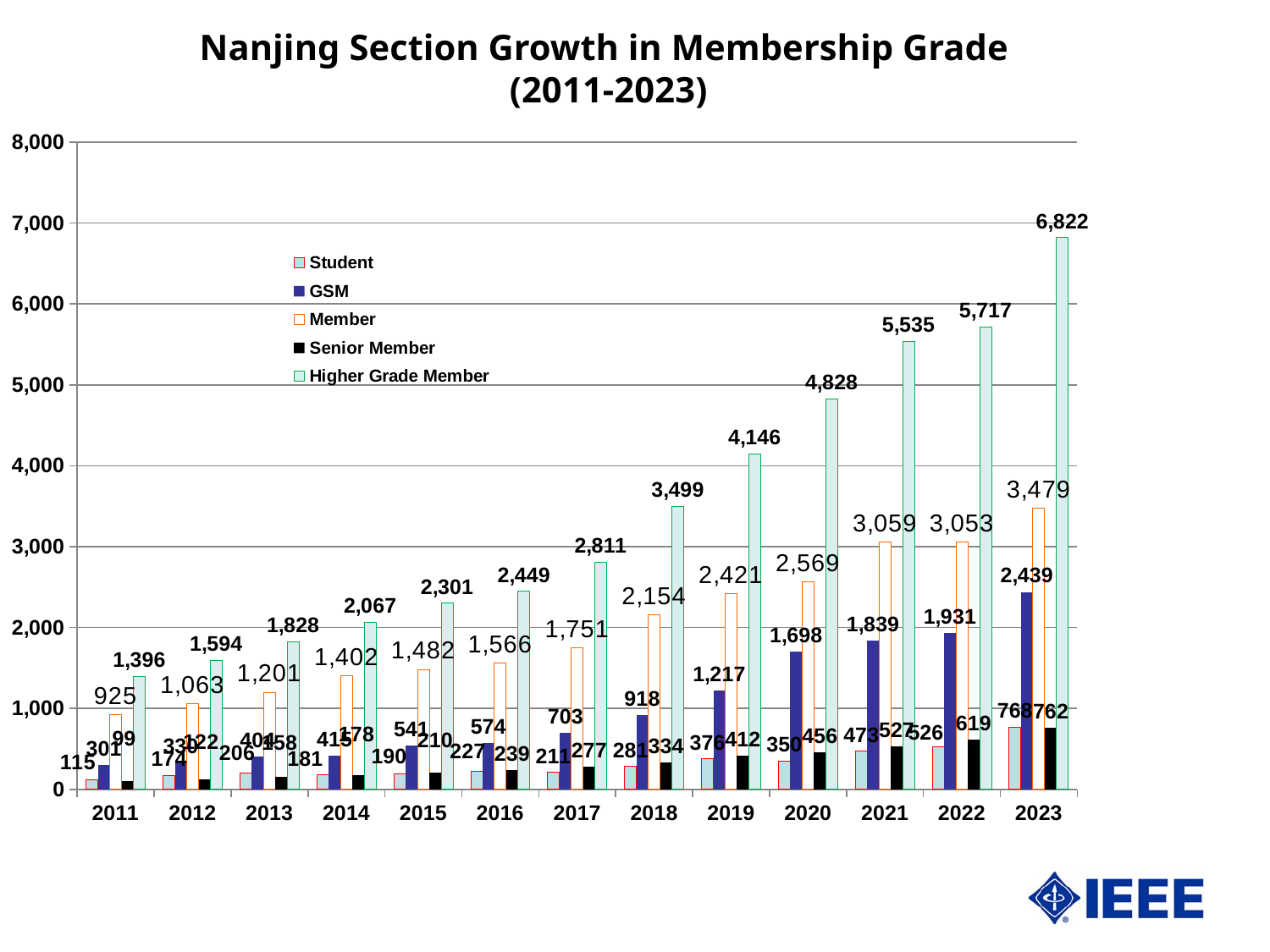
Does the Higher Grade Member value rise or fall from 2011 to 2023? rise What is the Member value for 2021? 3,059 What is the Higher Grade Member value for 2023? 6,822 What is the difference between the Higher Grade Member values for 2023 and 2022? 1,105 Is the Higher Grade Member value for 2020 greater or less than 4,000? greater Which is larger, the GSM value for 2023 or the Member value for 2020? Member value for 2020 Which year has the lowest Member value? 2011 How many series does the legend list? 5 How many years are shown on the x axis? 13 What is the GSM value for 2019? 1,217 What is the Senior Member value for 2022? 619 Which year has the highest Higher Grade Member value? 2023